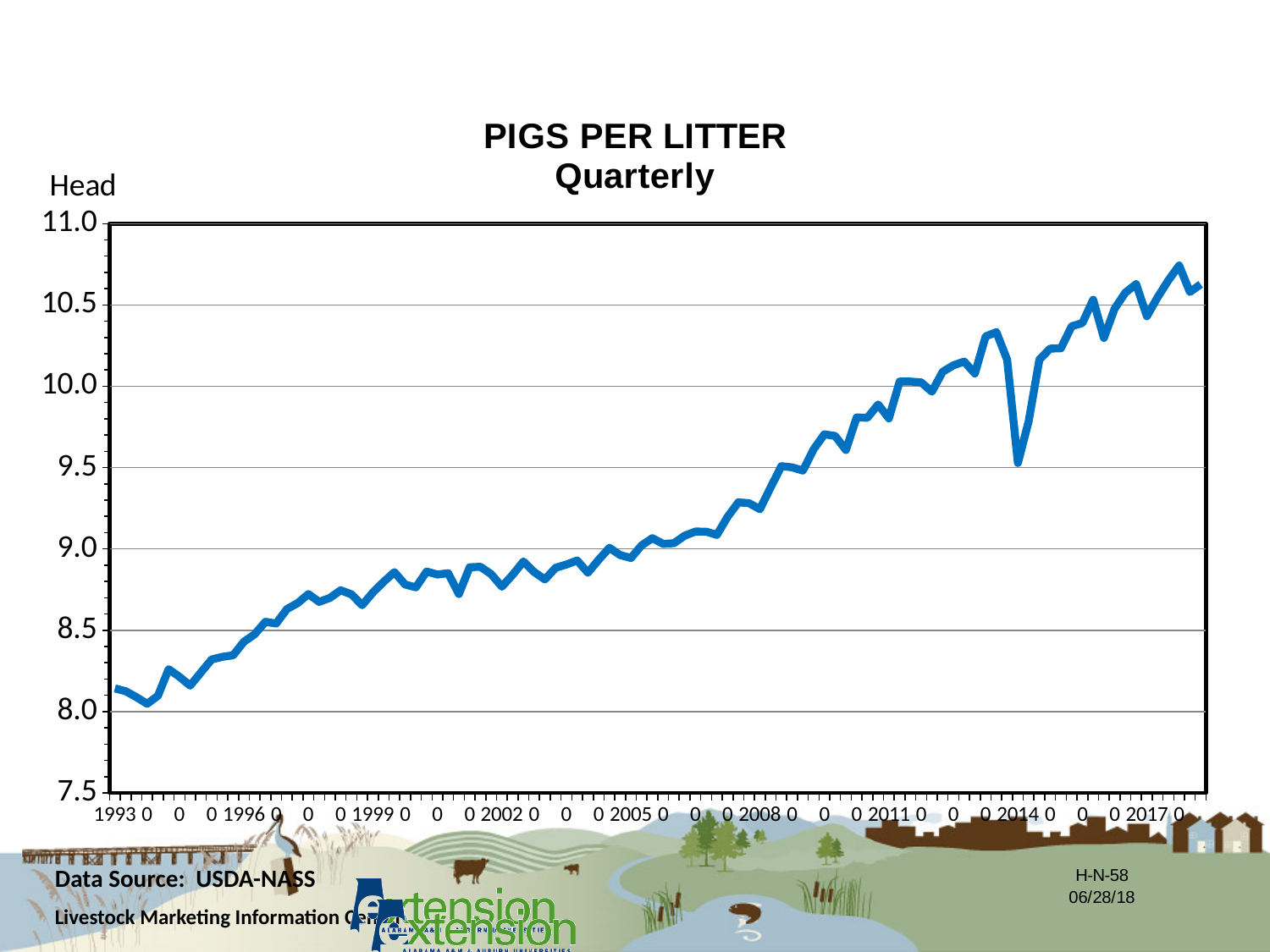
Which is larger, the value at the start of 2017 or the value at the start of 1993? 2017 How many data series are plotted on the chart? 1 Is the value at the start of 1999 greater or less than 8.5? greater Is the value at the start of 1993 greater or less than 8.0? greater Is the value at the start of 2002 greater or less than 9.0? less Overall, do the values rise or fall from 1993 to 2017? rise What is the title of the chart? PIGS PER LITTER Quarterly What label is shown on the vertical axis of the chart? Head In which year does the line reach its lowest value? 1993 What kind of chart is shown on the slide? line chart